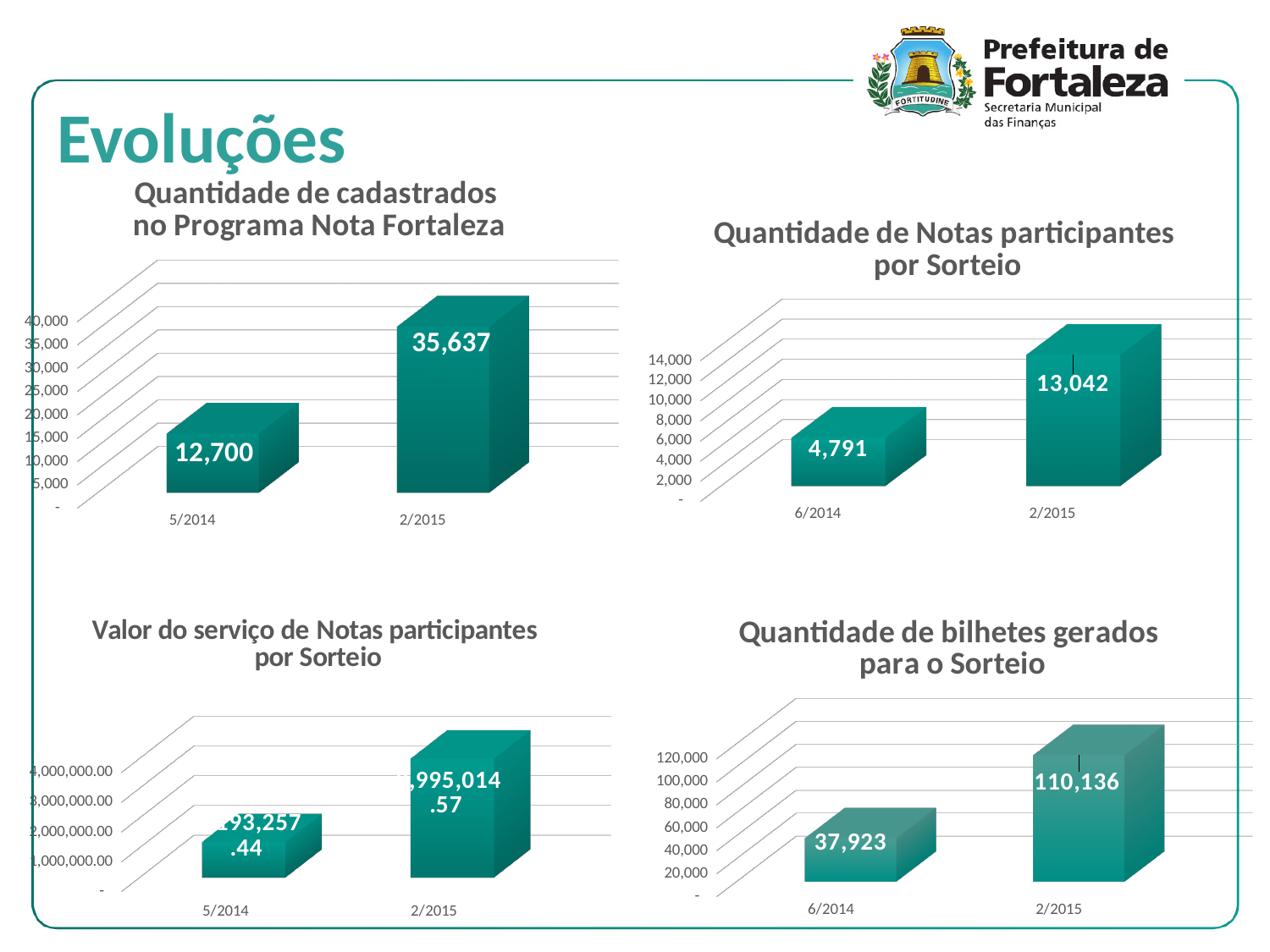
In the chart 'Quantidade de Notas participantes por Sorteio', by how much does the 2/2015 value exceed the 6/2014 value? 8,251 In the chart 'Quantidade de Notas participantes por Sorteio', what is the value for 2/2015? 13,042 In the chart 'Quantidade de bilhetes gerados para o Sorteio', what is the value for 6/2014? 37,923 In the chart 'Quantidade de Notas participantes por Sorteio', what is the value for 6/2014? 4,791 In the chart 'Valor do serviço de Notas participantes por Sorteio', is the value for 2/2015 greater or less than 3,000,000.00? greater In the chart 'Quantidade de Notas participantes por Sorteio', which period has the higher value? 2/2015 In the chart 'Quantidade de cadastrados no Programa Nota Fortaleza', what is the difference between the 2/2015 and 5/2014 values? 22,937 In the chart 'Quantidade de cadastrados no Programa Nota Fortaleza', what is the value for 2/2015? 35,637 In the chart 'Quantidade de bilhetes gerados para o Sorteio', what is the value for 2/2015? 110,136 In the chart 'Quantidade de cadastrados no Programa Nota Fortaleza', what is the value for 5/2014? 12,700 In the chart 'Quantidade de bilhetes gerados para o Sorteio', what is the difference between the 2/2015 and 6/2014 values? 72,213 How many charts are shown on the slide? 4